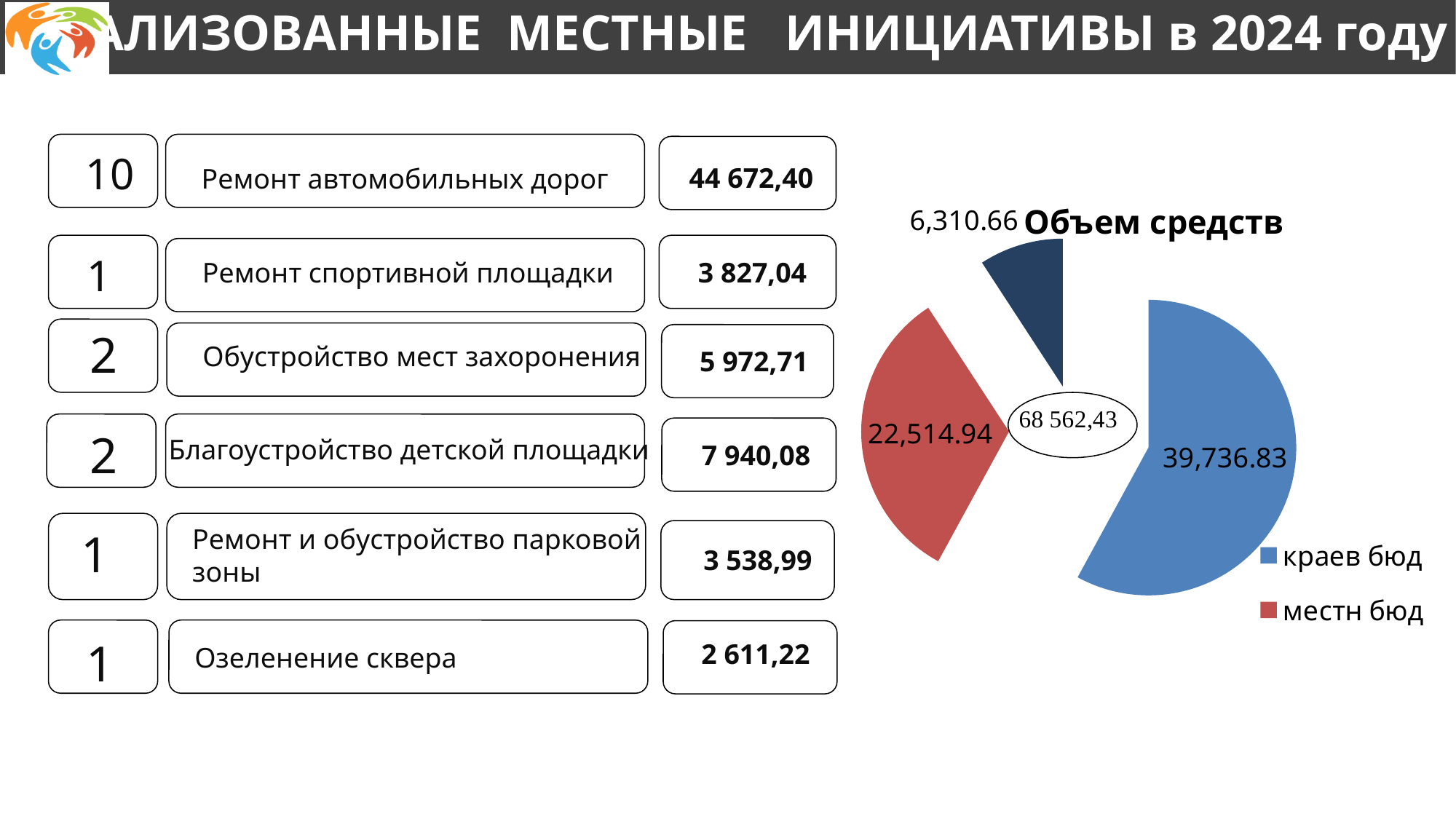
In the pie chart, what is the value for местн бюд? 22,514.94 What kind of chart is shown on the right of the slide? pie chart How many slices does the pie chart have? 3 What colour is the краев бюд slice in the pie chart? blue What total value is printed in the centre of the pie chart? 68 562,43 In the pie chart, what is the difference between the краев бюд value and the местн бюд value? 17,221.89 Which legend entry in the pie chart has the largest slice? краев бюд In the pie chart, what is the value for краев бюд? 39,736.83 In the pie chart, which is larger: краев бюд or местн бюд? краев бюд How many entries does the legend of the pie chart list? 2 What is the title of the pie chart on the right of the slide? Объем средств What is the value of the smallest slice in the pie chart? 6,310.66